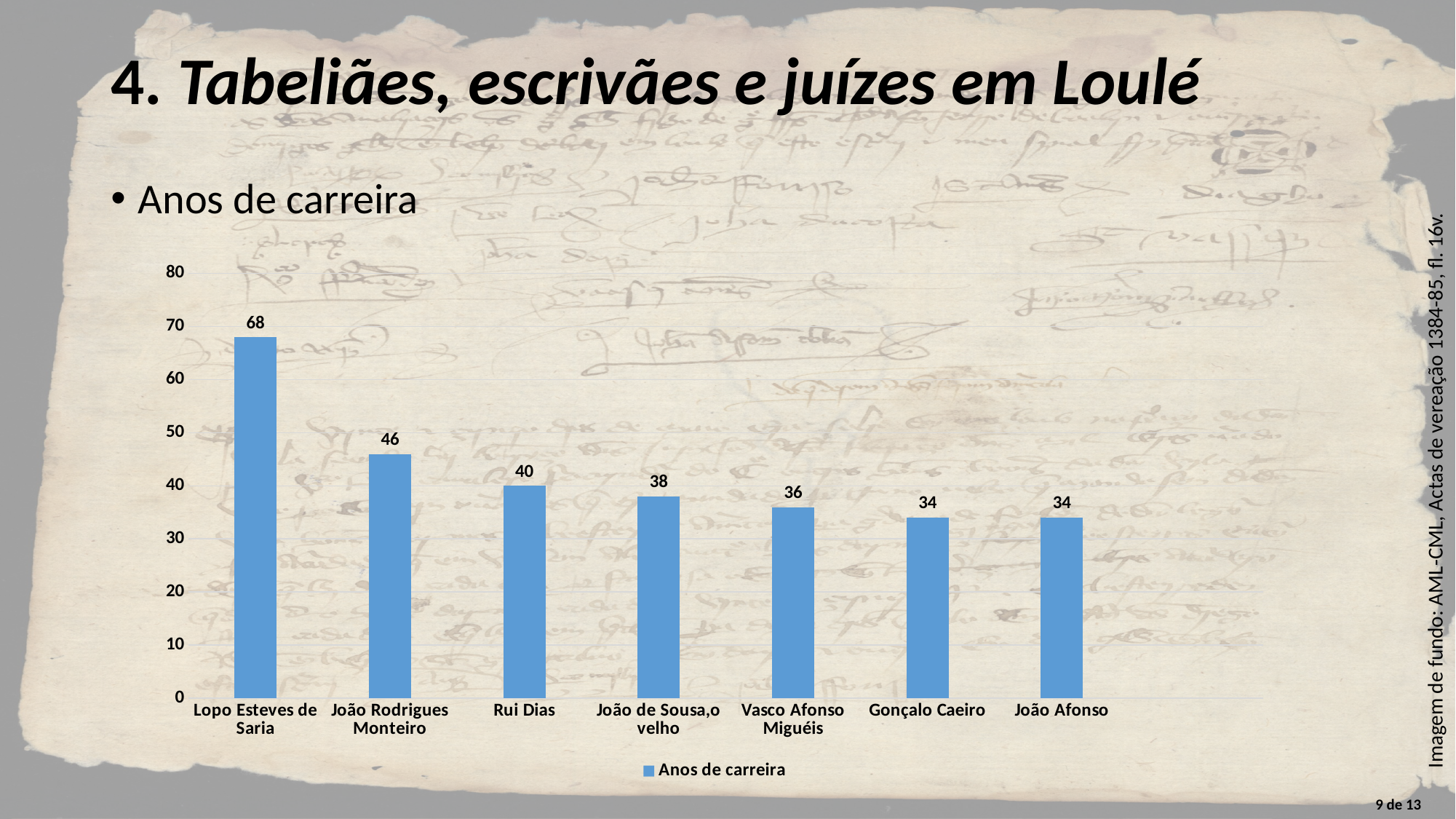
Which is larger, the value for João Rodrigues Monteiro or the value for Gonçalo Caeiro? João Rodrigues Monteiro What is the value for Vasco Afonso Miguéis? 36 Is the value for João Afonso greater or less than 40? less What is the value for Lopo Esteves de Saria? 68 What kind of chart is shown on the slide? bar chart What is the name of the series shown in the legend? Anos de carreira Which category has the highest value? Lopo Esteves de Saria What is the value for Rui Dias? 40 How many categories are shown on the x axis? 7 What is the difference between the values for Rui Dias and João de Sousa,o velho? 2 How many series does the legend list? 1 What is the difference between the values for Lopo Esteves de Saria and João Rodrigues Monteiro? 22